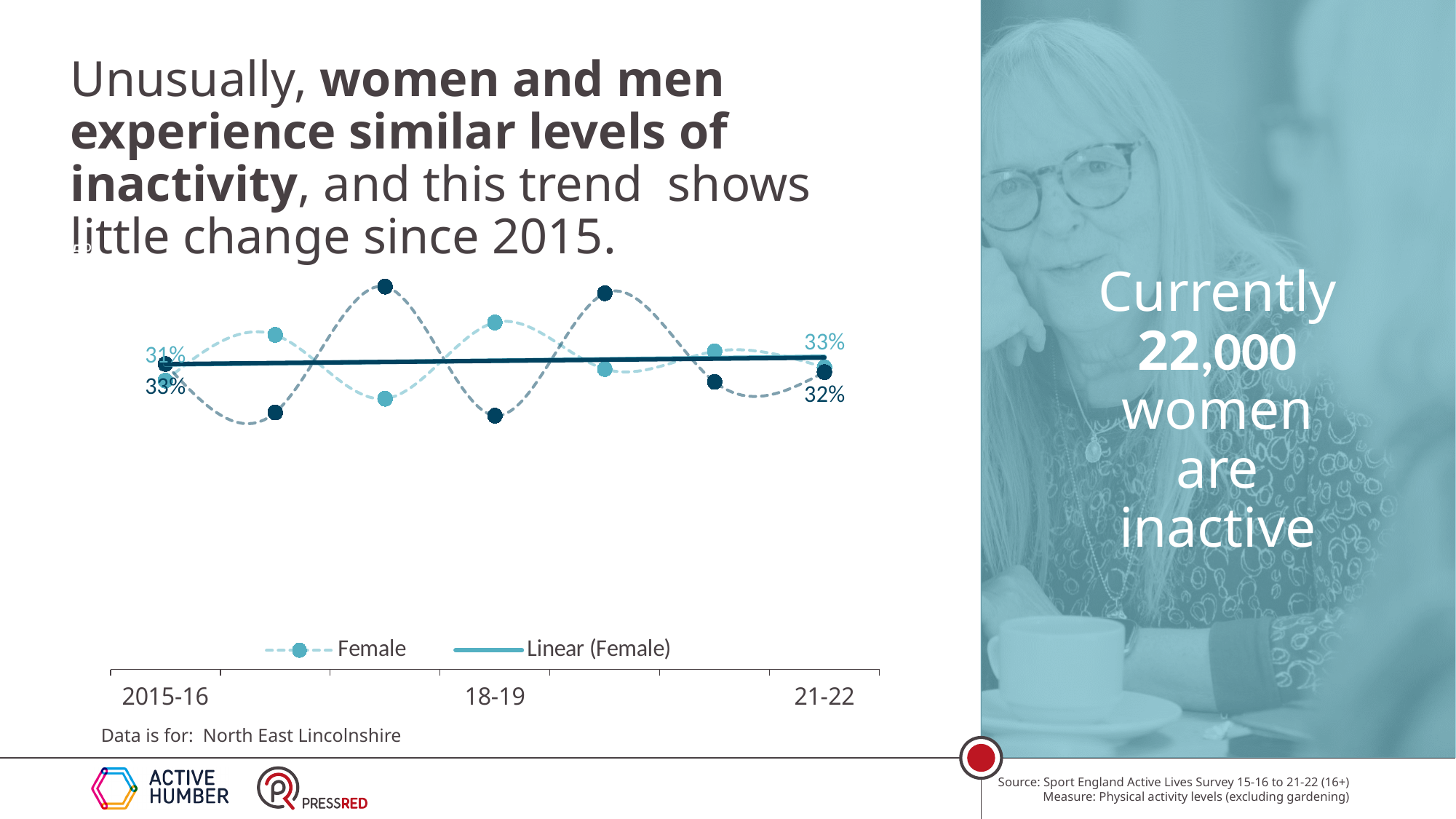
What is the Female value at 2015-16? 31% How many series does the legend list? 2 How many period labels are shown on the x axis? 3 How many data points are plotted for the Female series? 7 What is the first period label on the x axis? 2015-16 Is the Female value higher at 2015-16 or at 21-22? 21-22 What kind of chart is shown on the slide? Line chart Which area is the chart data for? North East Lincolnshire By how many percentage points did the Female value change from 2015-16 to 21-22? 2 percentage points What is the Female value at 21-22? 33% Does the Linear (Female) trend line rise or fall from 2015-16 to 21-22? Rises slightly